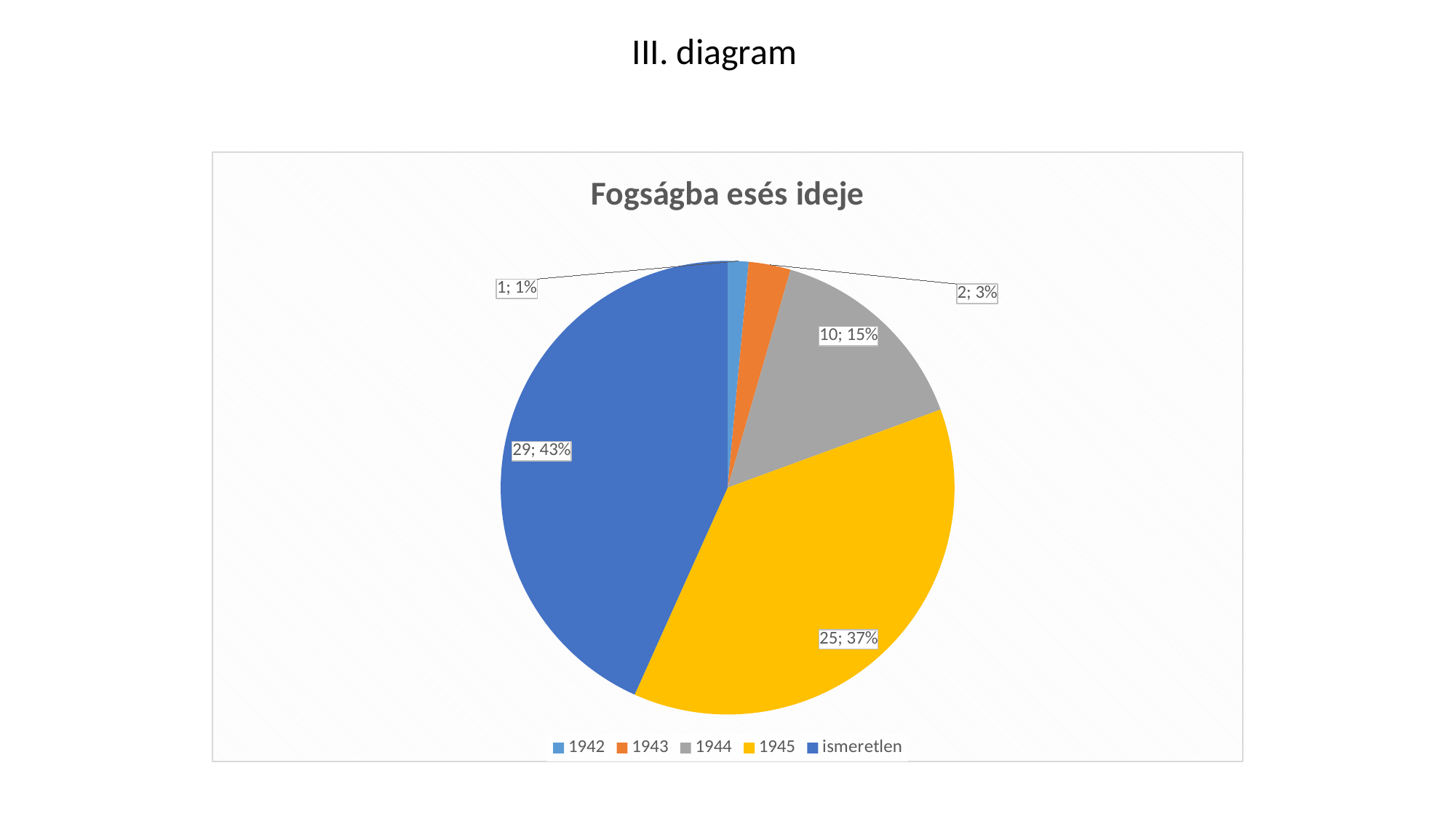
What is the value for ismeretlen? 29 What percentage share of the pie does 1943 have? 3% What type of chart is shown on the slide? pie chart Which is larger, the value for 1944 or the value for 1943? 1944 What is the value for 1944? 10 What is the value for 1945? 25 Which category has the largest slice? ismeretlen What is the difference between the values for ismeretlen and 1945? 4 How many categories does the legend list? 5 Which category has the smallest slice? 1942 What is the title of the chart? Fogságba esés ideje What percentage share of the pie does 1945 have? 37%